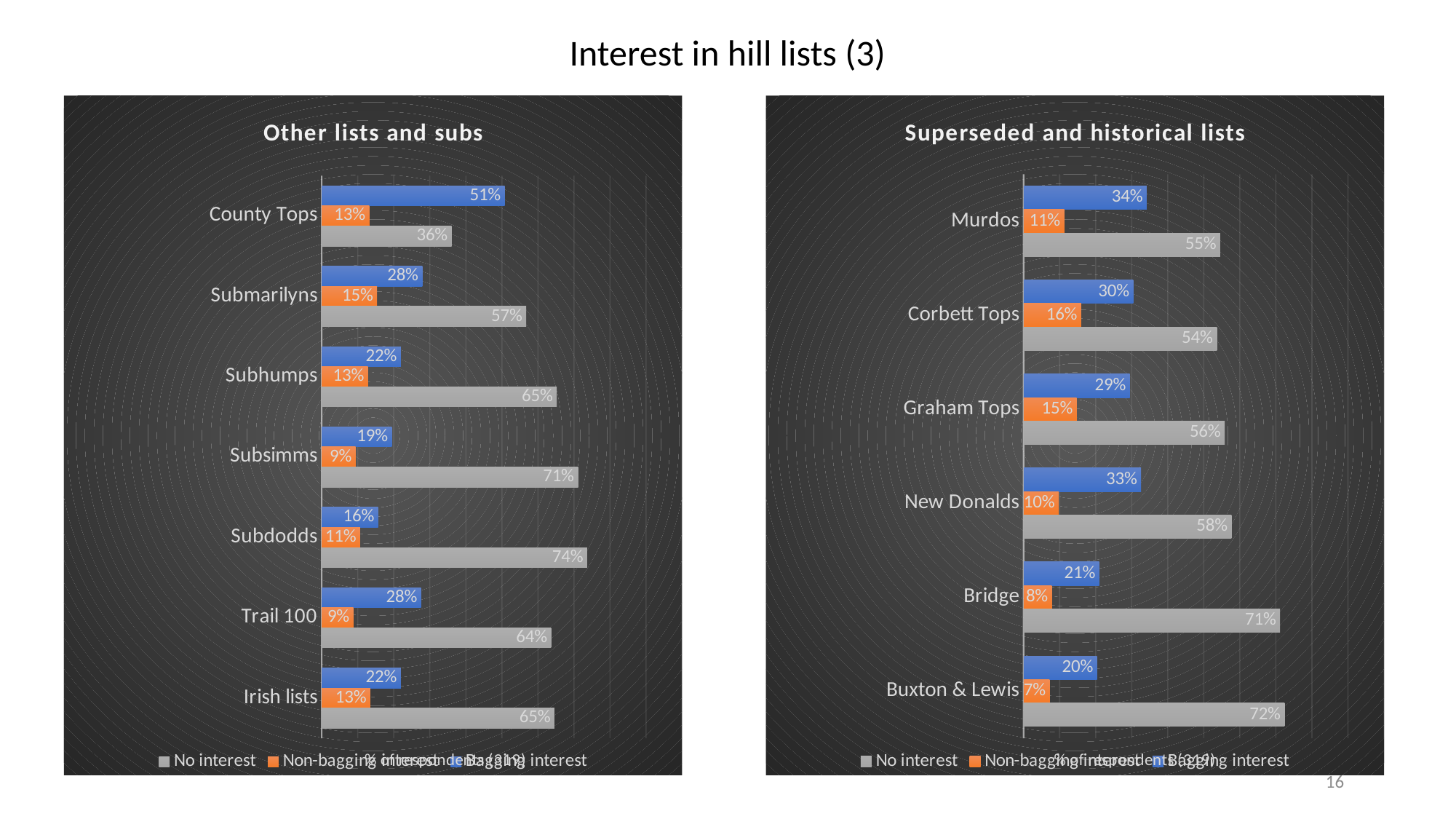
In the 'Superseded and historical lists' chart, what is the Non-bagging interest value for Corbett Tops? 16% In the 'Other lists and subs' chart, what is the Bagging interest value for County Tops? 51% In the 'Superseded and historical lists' chart, which category has the lowest Non-bagging interest value? Buxton & Lewis In the 'Other lists and subs' chart, what is the difference between the No interest values for Subsimms and County Tops? 35% In the 'Superseded and historical lists' chart, which category has the highest Bagging interest value? Murdos In the 'Other lists and subs' chart, what is the No interest value for Subdodds? 74% What type of chart is the 'Other lists and subs' chart? Bar chart How many categories are shown in the 'Superseded and historical lists' chart? 6 In the 'Other lists and subs' chart, which category has the lowest Bagging interest value? Subdodds In the 'Superseded and historical lists' chart, is the Bagging interest value larger for New Donalds or for Bridge? New Donalds In the 'Other lists and subs' chart, which category has the highest No interest value? Subdodds How many series does the legend of the 'Other lists and subs' chart list? 3